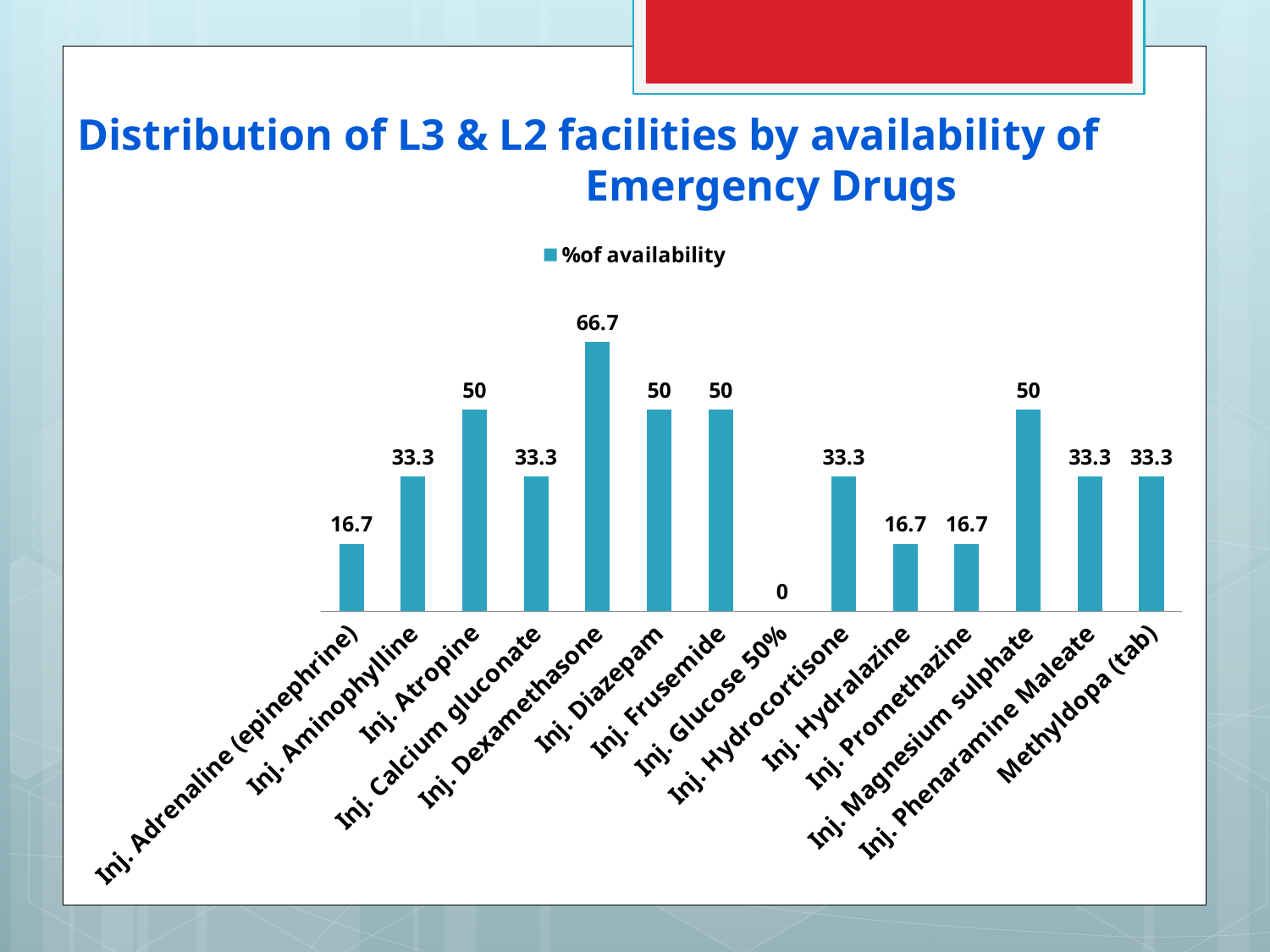
How many emergency drugs are shown on the x axis of the chart? 14 Which emergency drug has the highest % of availability? Inj. Dexamethasone How many series does the legend list? 1 What is the difference in % of availability between Inj. Dexamethasone and Inj. Adrenaline (epinephrine)? 50 What is the % of availability for Inj. Glucose 50%? 0 What is the legend entry of the chart? %of availability What is the % of availability for Inj. Magnesium sulphate? 50 What is the % of availability for Inj. Dexamethasone? 66.7 What kind of chart is shown on the slide? Bar chart What is the % of availability for Inj. Hydralazine? 16.7 Which has a higher % of availability, Inj. Atropine or Inj. Calcium gluconate? Inj. Atropine Which emergency drug has the lowest % of availability? Inj. Glucose 50%